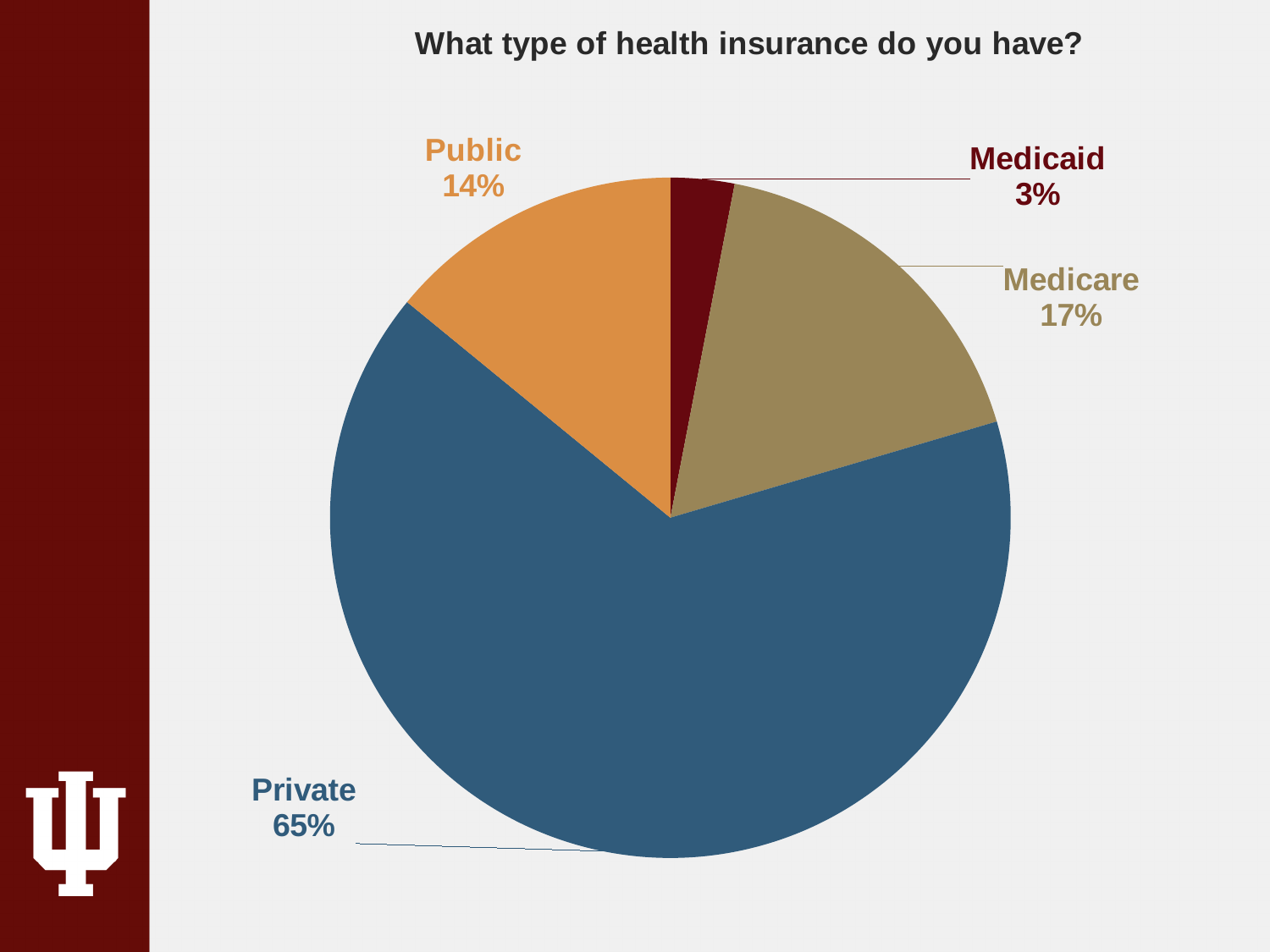
What is the title of the chart? What type of health insurance do you have? What share of the pie is Medicaid? 3% Which is larger, the Public slice or the Medicare slice? Medicare What is the difference in percentage points between Medicare and Public? 3 What share of the pie is Private? 65% What share of the pie is Medicare? 17% Which category has the smallest slice of the pie? Medicaid How many categories are shown in the pie chart? 4 Which category has the largest slice of the pie? Private What kind of chart is shown on the slide? Pie chart What is the difference in percentage points between Private and Medicare? 48